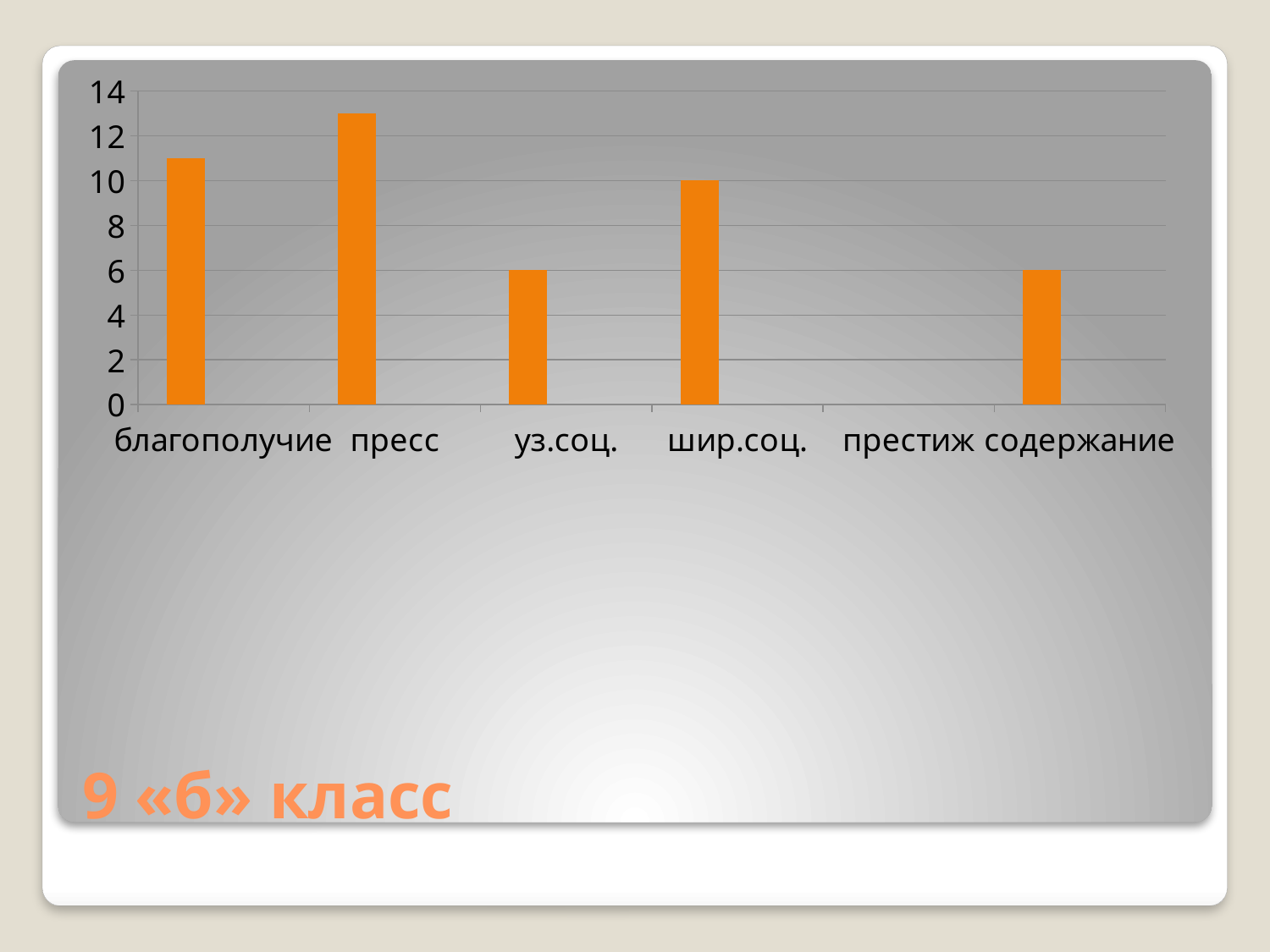
Which category has the highest bar in the chart? пресс What is the value for уз.соц.? 6 What kind of chart is shown on the slide? bar chart What is the value for шир.соц.? 10 What is the difference between the values for шир.соц. and уз.соц.? 4 Is the value for благополучие greater or less than 10? greater What text is shown as the title at the bottom of the slide? 9 «б» класс How many categories are shown on the x axis of the chart? 6 Which is larger, the value for шир.соц. or the value for уз.соц.? шир.соц. What is the value for содержание? 6 Is the value for пресс greater or less than 12? greater Which is larger, the value for благополучие or the value for пресс? пресс